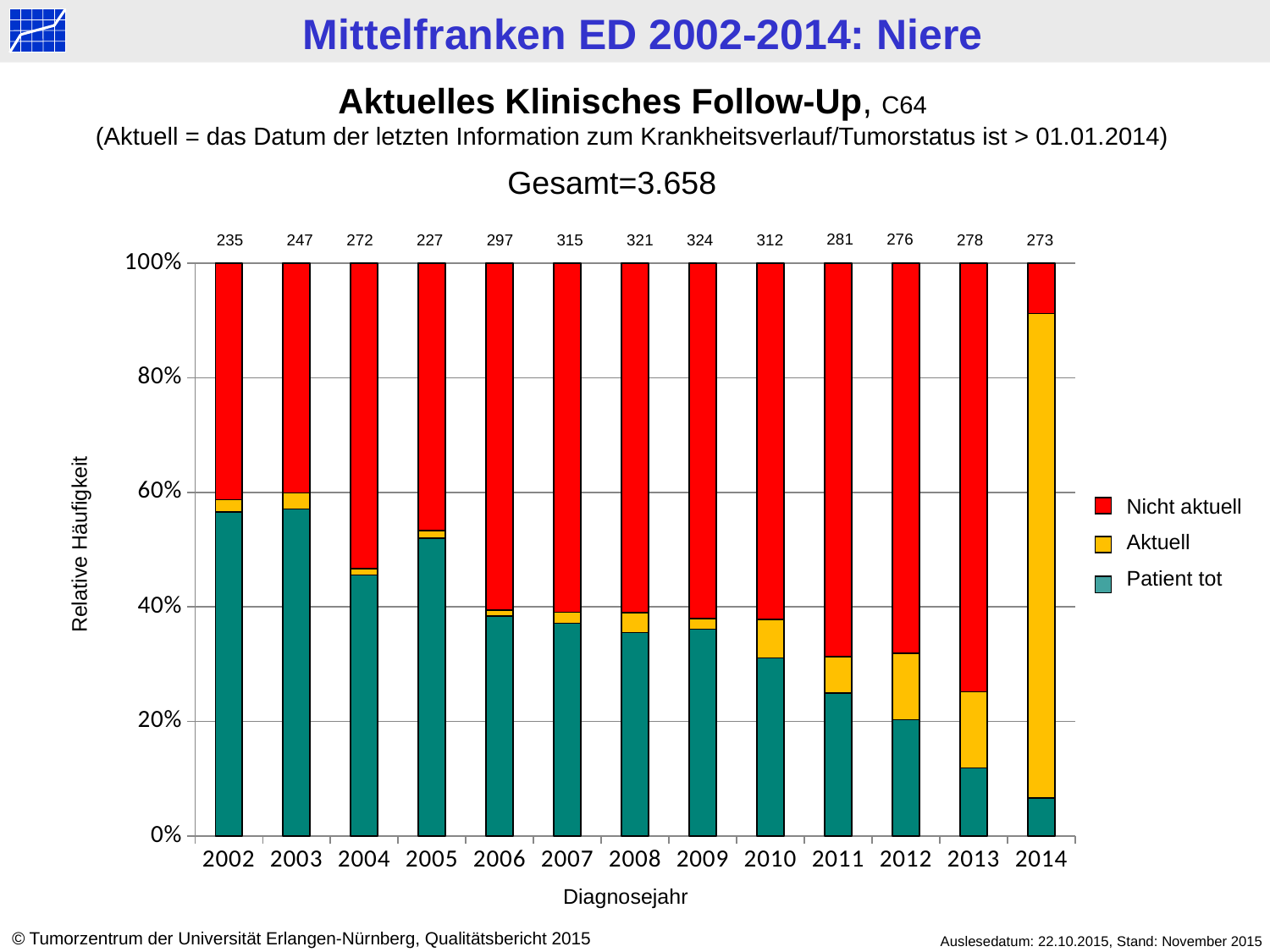
How many series does the legend list? 3 Which diagnosis year has the lowest number printed above its bar? 2005 What number is printed above the bar for 2009? 324 What kind of chart is shown on the slide? Stacked bar chart What is the difference between the numbers printed above the bars for 2009 and 2005? 97 Which year has the larger number printed above its bar, 2006 or 2010? 2010 Is the 'Patient tot' share for 2014 greater or less than 20%? less Does the 'Patient tot' share generally rise or fall from 2002 to 2014? fall What number is printed above the bar for 2005? 227 Which diagnosis year has the highest number printed above its bar? 2009 Is the 'Patient tot' share for 2002 greater or less than 40%? greater How many diagnosis years are shown on the x axis? 13